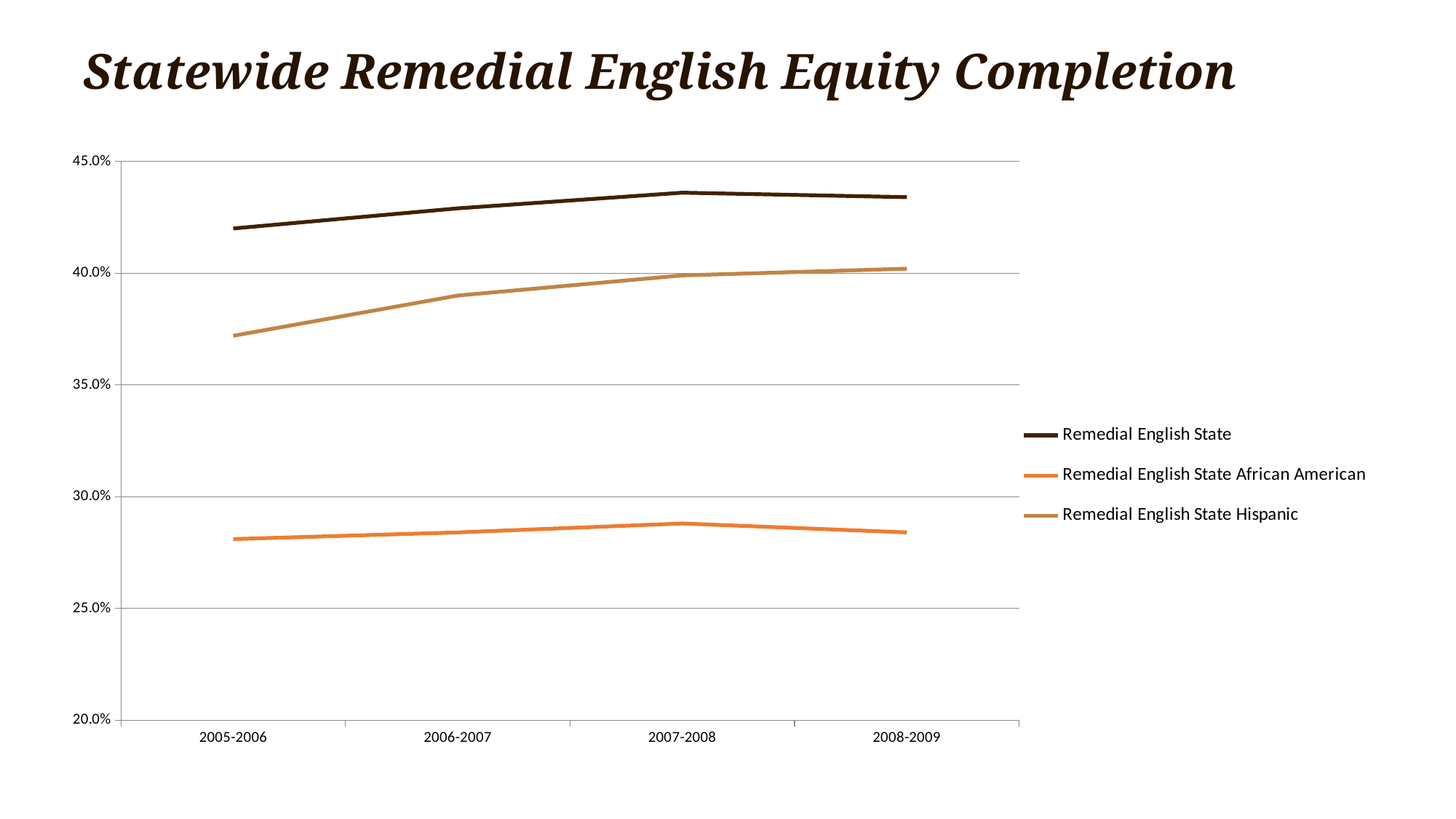
How many academic years are shown on the x axis? 4 Which is larger in 2008-2009, Remedial English State or Remedial English State Hispanic? Remedial English State What is the title of the chart on the slide? Statewide Remedial English Equity Completion Is the value for Remedial English State Hispanic in 2005-2006 greater or less than 35.0%? greater Which series has the lowest value in 2005-2006? Remedial English State African American Is the value for Remedial English State African American in 2007-2008 greater or less than 30.0%? less What kind of chart is shown on the slide? line chart Is the value for Remedial English State in 2005-2006 greater or less than 40.0%? greater How many series does the legend list? 3 Does the Remedial English State Hispanic line rise or fall from 2005-2006 to 2008-2009? rise Which series has the highest value in 2007-2008? Remedial English State